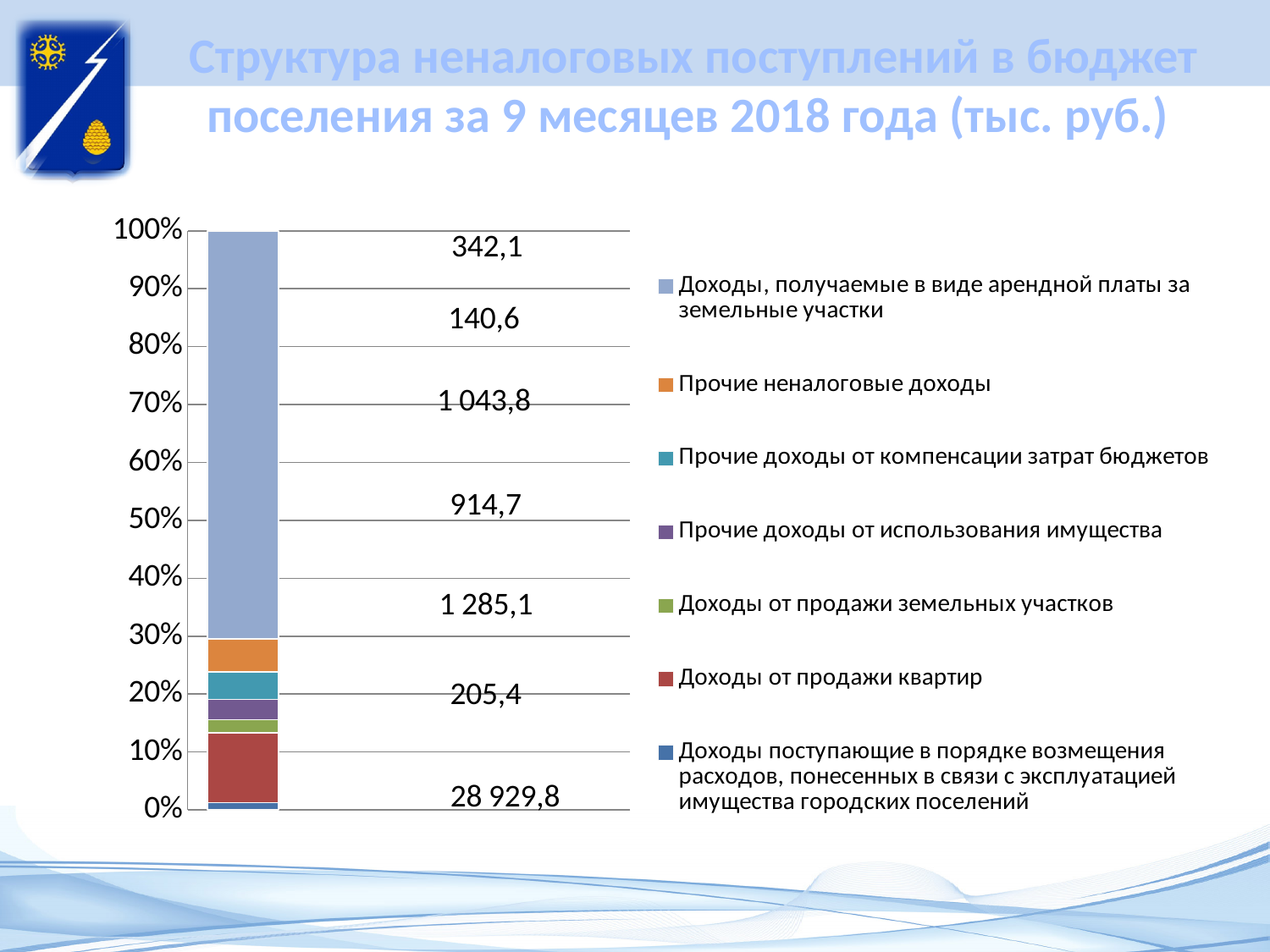
What is the maximum value shown on the vertical axis? 100% What is the topmost data label printed on the chart? 342,1 What is the smallest data label printed on the chart? 140,6 Which series is listed last in the legend? Доходы поступающие в порядке возмещения расходов, понесенных в связи с эксплуатацией имущества городских поселений Is the share of the bar taken by 'Доходы от продажи квартир' greater or less than 20%? less What is the largest data label printed on the chart? 28 929,8 How many bars are plotted in the chart? 1 Which segment is larger in the bar: 'Доходы от продажи квартир' or 'Доходы от продажи земельных участков'? Доходы от продажи квартир Is the share of the bar taken by 'Доходы, получаемые в виде арендной платы за земельные участки' greater or less than 60%? greater How many series does the legend list? 7 What kind of chart is shown on the slide? Stacked bar chart Which series occupies the largest segment of the bar? Доходы, получаемые в виде арендной платы за земельные участки